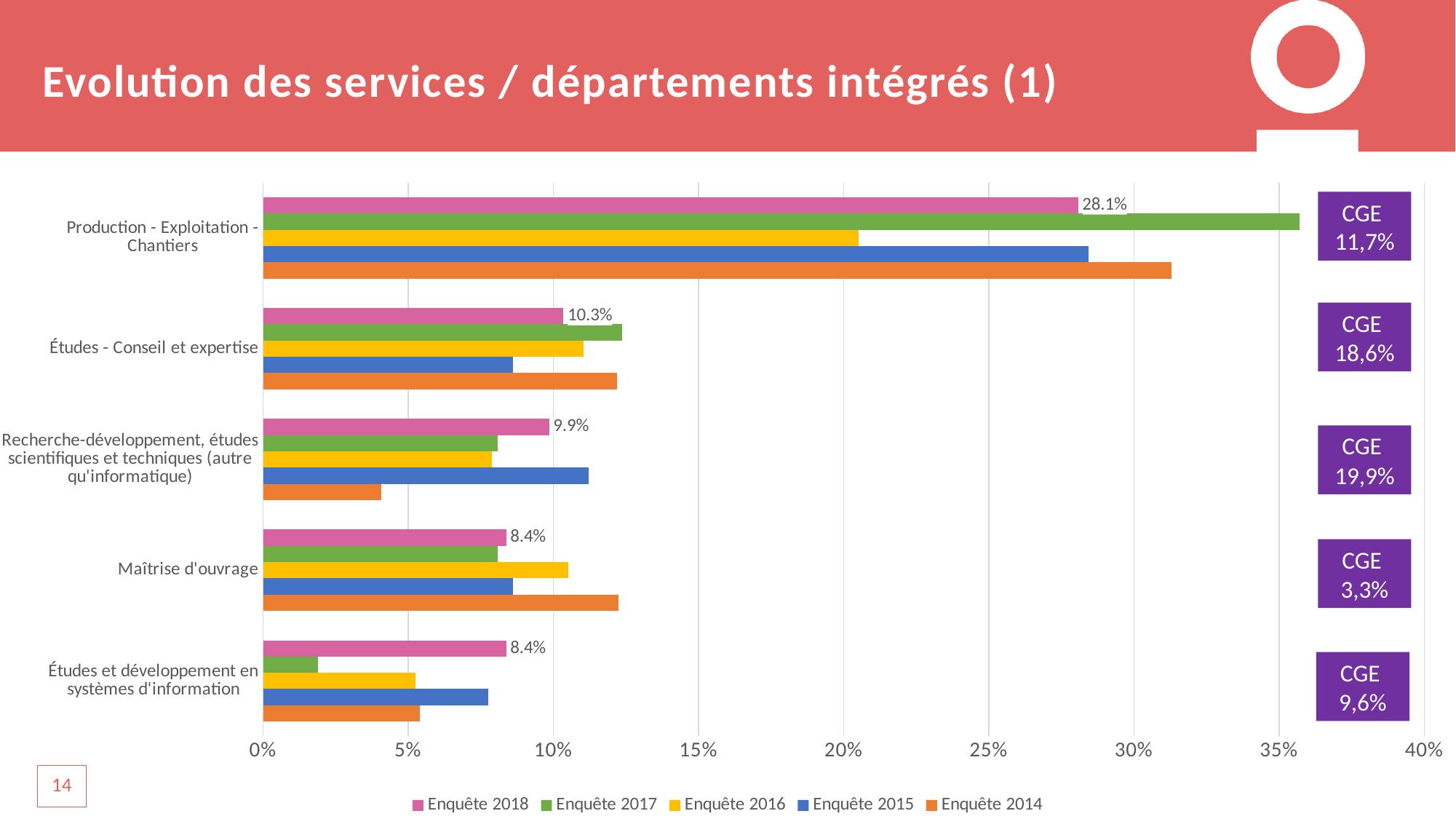
What is the Enquête 2018 value for Recherche-développement, études scientifiques et techniques (autre qu'informatique)? 9.9% How many series does the legend list? 5 Is the Enquête 2014 value for Production - Exploitation - Chantiers greater or less than 30%? greater Which category has the highest Enquête 2018 value? Production - Exploitation - Chantiers Is the Enquête 2017 value for Études et développement en systèmes d'information greater or less than 5%? less What is the Enquête 2018 value for Production - Exploitation - Chantiers? 28.1% How many categories are shown on the chart? 5 For Recherche-développement, études scientifiques et techniques (autre qu'informatique), which is larger: the Enquête 2014 value or the Enquête 2018 value? Enquête 2018 For Production - Exploitation - Chantiers, which is larger: the Enquête 2017 value or the Enquête 2018 value? Enquête 2017 What is the Enquête 2018 value for Études - Conseil et expertise? 10.3% What is the Enquête 2018 value for Maîtrise d'ouvrage? 8.4% What is the difference between the Enquête 2018 values for Production - Exploitation - Chantiers and Études - Conseil et expertise? 17.8%